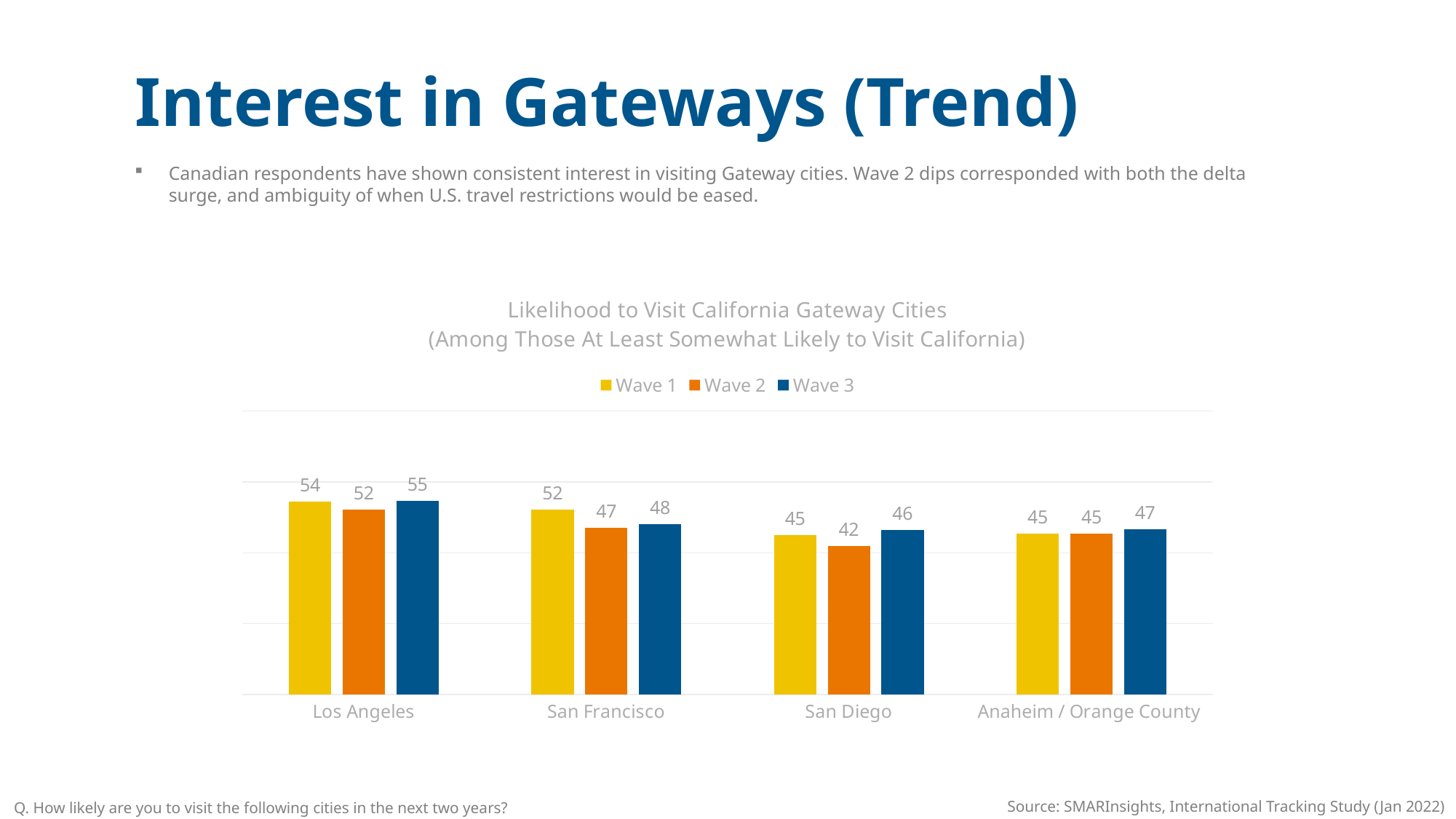
How many series does the legend list? 3 What colour represents Wave 2 in the chart? Orange Which is larger for San Diego: the Wave 1 value or the Wave 3 value? Wave 3 Which city has the lowest Wave 2 value? San Diego What is the Wave 1 value for Los Angeles? 54 Which city has the highest Wave 3 value? Los Angeles What kind of chart is shown? Bar chart What is the Wave 2 value for San Diego? 42 How many cities are shown on the x axis? 4 Do the Wave 1 values rise or fall from Los Angeles to San Diego? Fall What is the Wave 3 value for Anaheim / Orange County? 47 What is the difference between the Wave 1 and Wave 2 values for San Francisco? 5